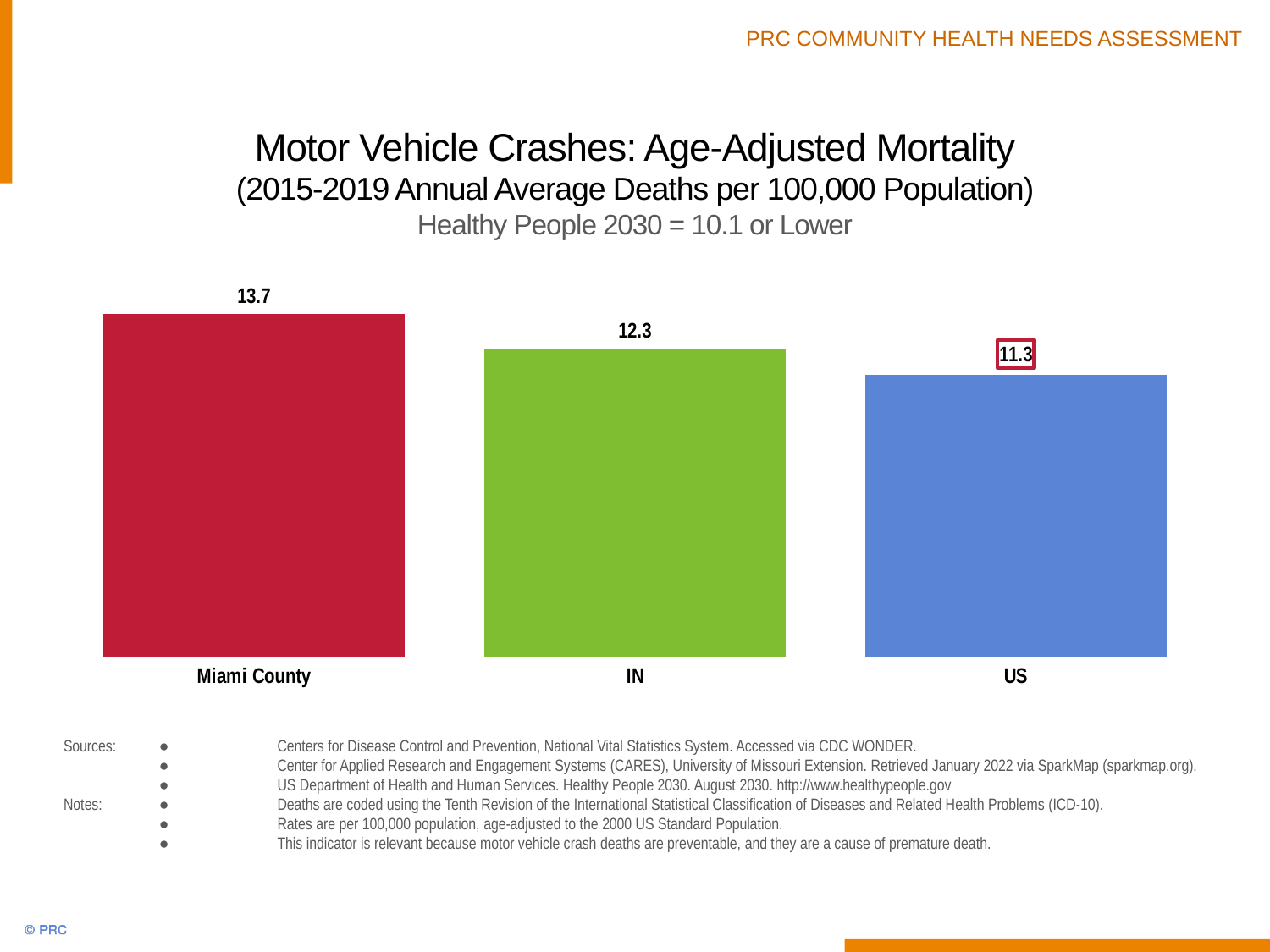
Which category has the lowest value? US What is the age-adjusted motor vehicle crash mortality rate for Miami County? 13.7 How many categories are shown in the chart? 3 What is the Healthy People 2030 target stated in the chart title? 10.1 or Lower Which category has the highest value? Miami County What is the value shown for IN? 12.3 Do the values rise or fall from left to right across the categories? Fall What is the difference between the Miami County value and the IN value? 1.4 What kind of chart is shown on the slide? Bar chart What is the value shown for US? 11.3 Which is larger, the value for IN or the value for US? IN What is the difference between the Miami County value and the US value? 2.4